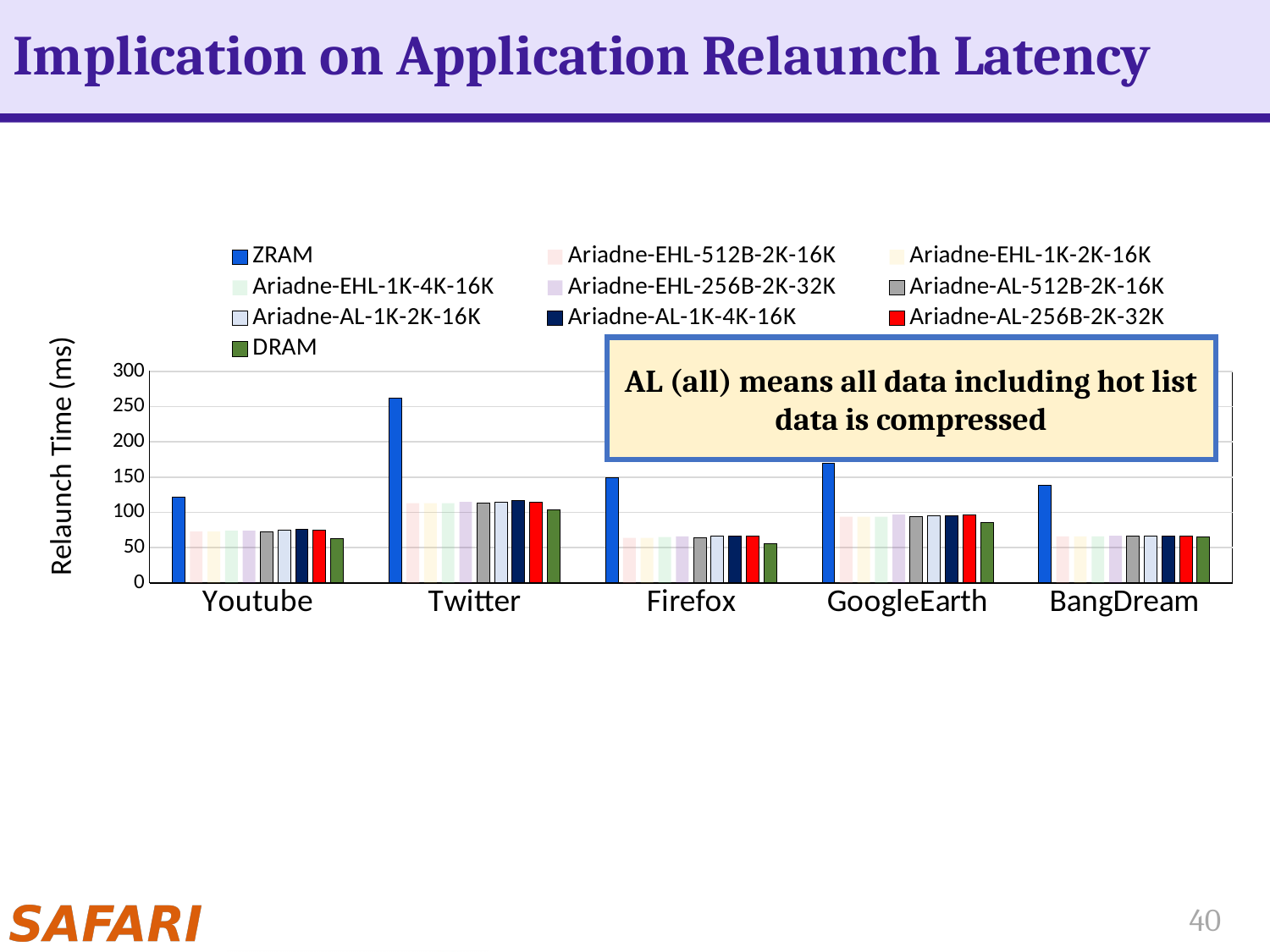
How many series does the legend list? 10 What kind of chart is shown on the slide? bar chart Is the ZRAM value for Youtube greater or less than 100? greater For which application is the ZRAM relaunch time highest? Twitter What is the label of the y axis? Relaunch Time (ms) Which application has the larger DRAM relaunch time: Twitter or Firefox? Twitter Which is larger for Firefox: the ZRAM value or the DRAM value? ZRAM Is the DRAM value for Youtube greater or less than 100? less How many applications (categories) are shown on the x axis? 5 Is the ZRAM value for Twitter greater or less than 200? greater According to the callout box on the chart, what does AL (all) mean? All data including hot list data is compressed